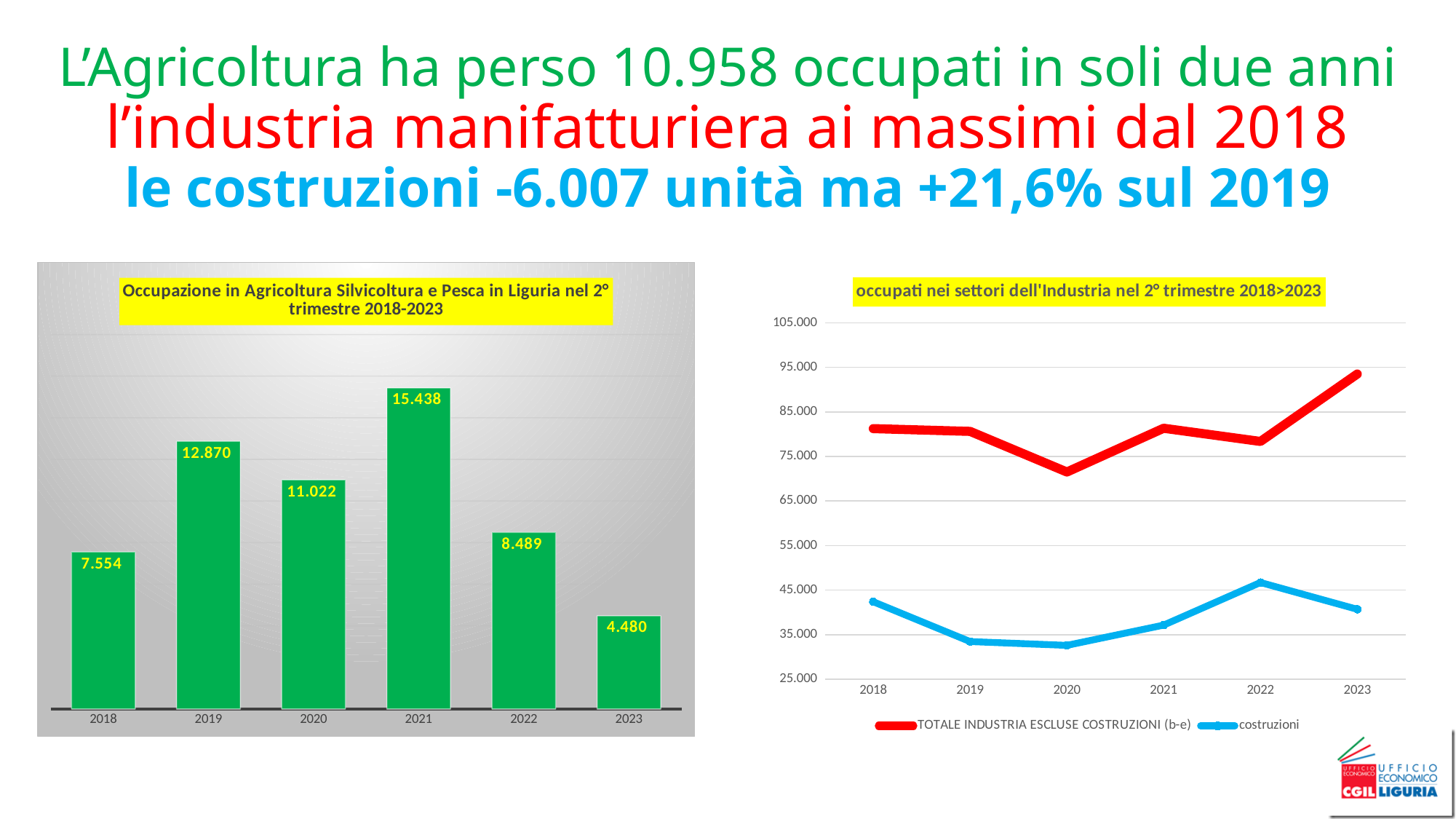
What kind of chart is the left chart (Occupazione in Agricoltura Silvicoltura e Pesca in Liguria)? bar chart In the right chart (occupati nei settori dell'Industria), is the value for TOTALE INDUSTRIA ESCLUSE COSTRUZIONI (b-e) in 2020 greater or less than 75.000? less In the right chart (occupati nei settori dell'Industria), which colour is used for the costruzioni series? blue In the left chart (Occupazione in Agricoltura Silvicoltura e Pesca in Liguria), which is larger, the value for 2019 or the value for 2020? 2019 In the left chart (Occupazione in Agricoltura Silvicoltura e Pesca in Liguria), what is the value for 2023? 4.480 How many years are shown in the left chart (Occupazione in Agricoltura Silvicoltura e Pesca in Liguria)? 6 In the left chart (Occupazione in Agricoltura Silvicoltura e Pesca in Liguria), what is the difference between the 2021 value and the 2023 value? 10.958 In the left chart (Occupazione in Agricoltura Silvicoltura e Pesca in Liguria), which year has the highest value? 2021 In the left chart (Occupazione in Agricoltura Silvicoltura e Pesca in Liguria), what is the value for 2021? 15.438 How many series does the legend of the right chart (occupati nei settori dell'Industria) list? 2 In the right chart (occupati nei settori dell'Industria), is the value for costruzioni in 2022 greater or less than 45.000? greater In the left chart (Occupazione in Agricoltura Silvicoltura e Pesca in Liguria), which year has the lowest value? 2023